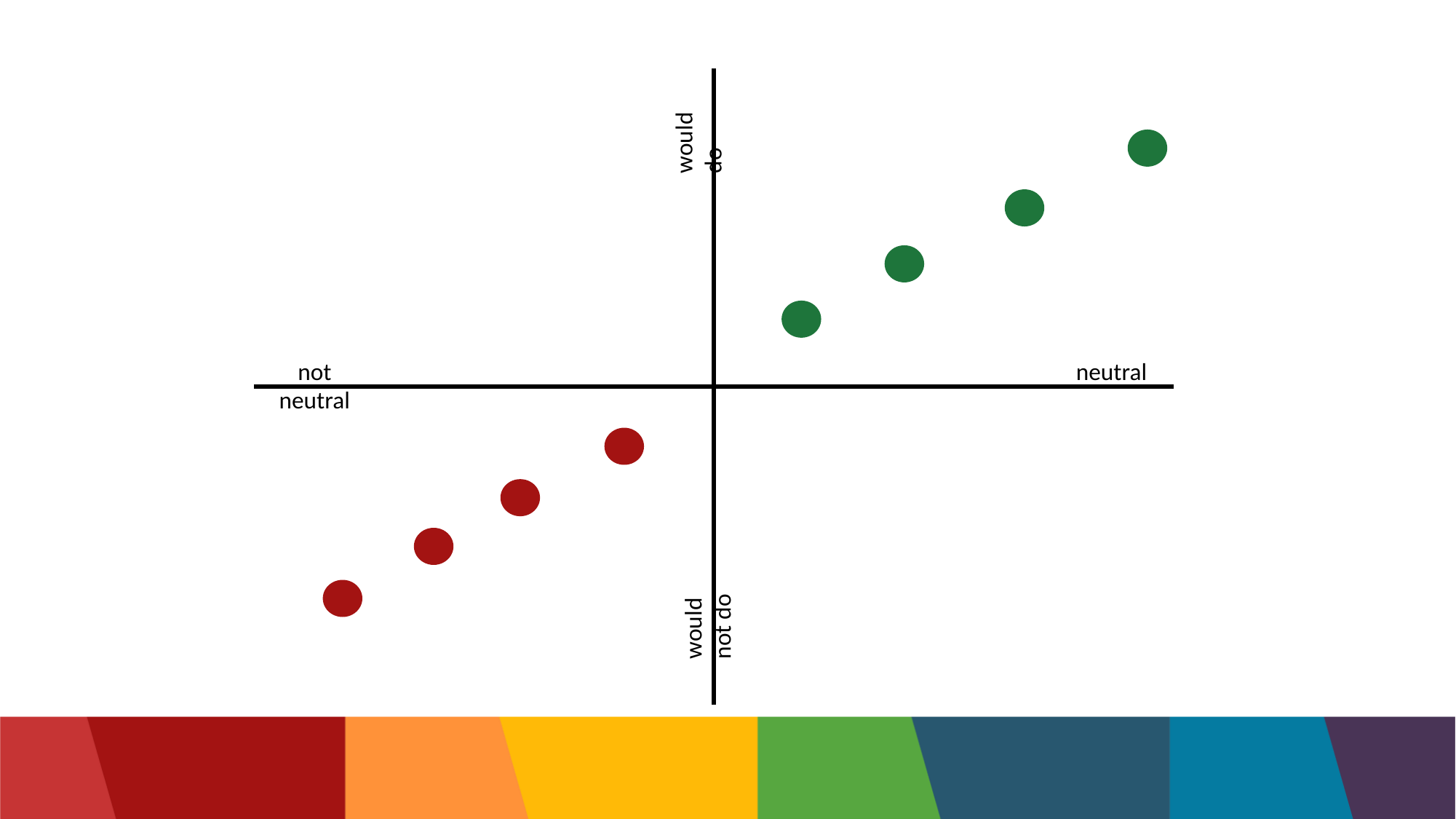
Which colour of points lies on the 'neutral' side of the horizontal axis? green How many points are plotted on the chart in total? 8 What is the label at the top of the vertical axis? would do Do the green points rise or fall as they move to the right along the x axis? rise How many green points are plotted on the chart? 4 Do the red points rise or fall as they move to the right along the x axis? rise Which colour of points lies in the 'would not do' half of the chart? red In which quadrant of the chart are the green points located? upper right What kind of chart is shown on the slide? scatter chart How many red points are plotted on the chart? 4